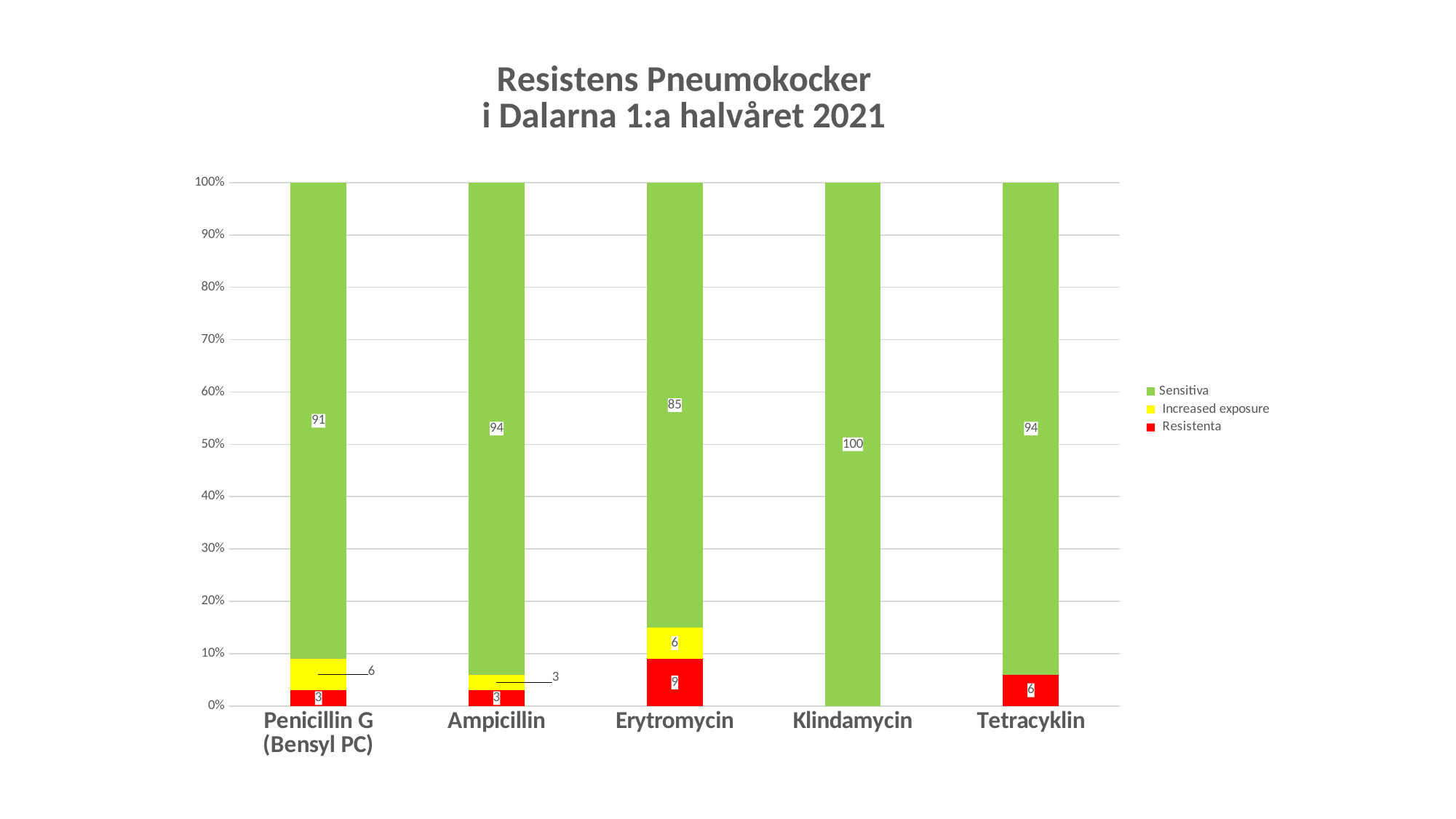
What is the Resistenta value for Tetracyklin? 6 How many antibiotics are shown on the x axis? 5 Which is larger, the Resistenta value for Erytromycin or for Ampicillin? Erytromycin Which antibiotic has the highest Sensitiva value? Klindamycin What is the Resistenta value for Erytromycin? 9 What kind of chart is shown on the slide? Stacked bar chart What is the Increased exposure value for Penicillin G (Bensyl PC)? 6 What is the Sensitiva value for Erytromycin? 85 Which antibiotic has the lowest Sensitiva value? Erytromycin What is the difference between the Sensitiva values for Ampicillin and Erytromycin? 9 Which colour represents the Resistenta series? Red How many series does the legend list? 3